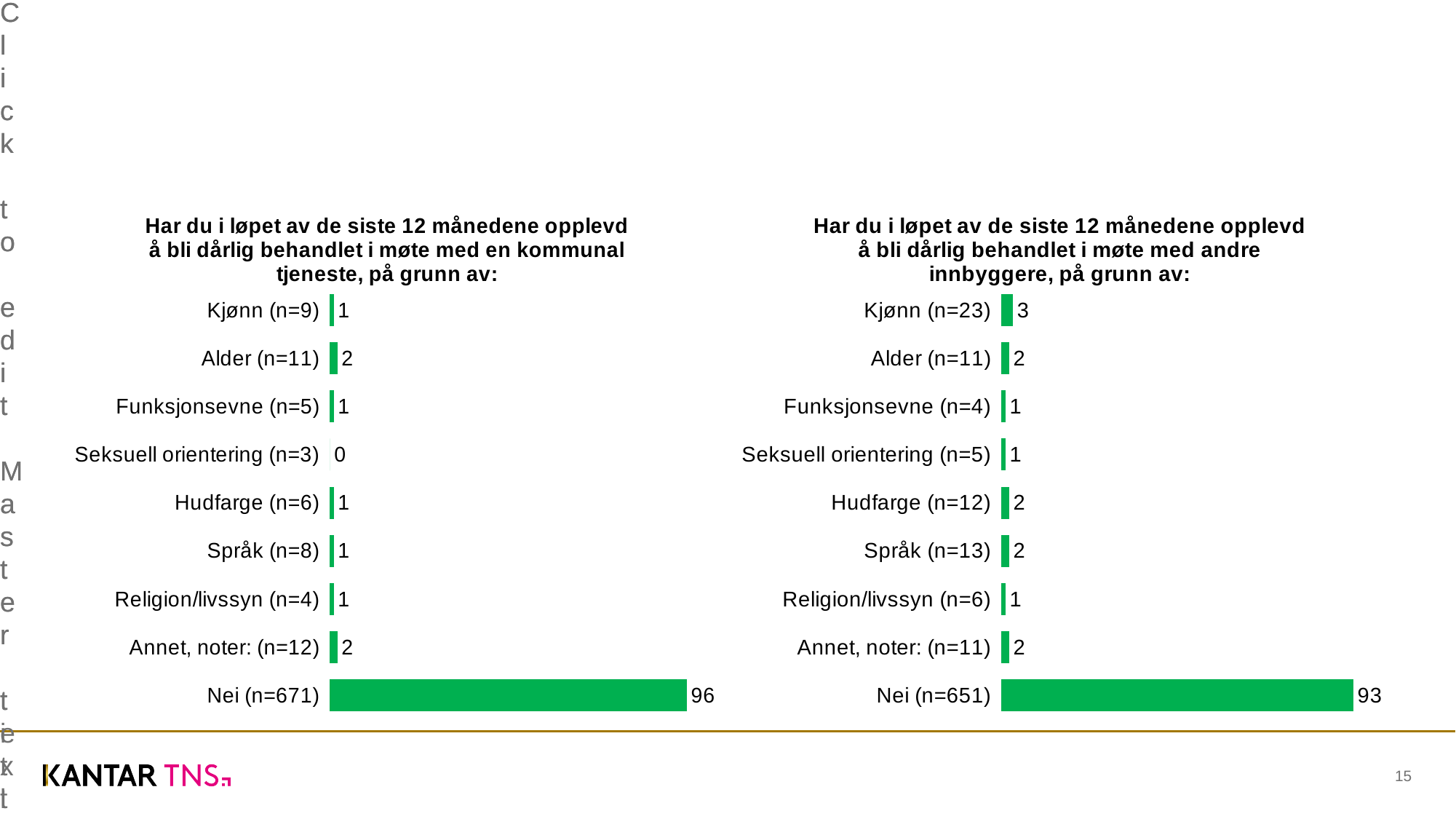
In the right chart (andre innbyggere), what is the difference between Nei (n=651) and Kjønn (n=23)? 90 In the left chart (kommunal tjeneste), which category has the lowest value? Seksuell orientering (n=3) In the right chart (andre innbyggere), what is the value for Kjønn (n=23)? 3 In the left chart (kommunal tjeneste), what is the value for Seksuell orientering (n=3)? 0 In the right chart (andre innbyggere), what is the value for Nei (n=651)? 93 What is the difference between the Nei value in the left chart (96) and the Nei value in the right chart (93)? 3 What type of chart is used on this slide? Bar chart In the left chart (kommunal tjeneste), which category has the highest value? Nei (n=671) In the left chart (kommunal tjeneste), what is the value for Nei (n=671)? 96 How many categories are shown in the left chart (kommunal tjeneste)? 9 What colour are the bars in both charts? Green Which is larger: the value for Kjønn in the left chart or the value for Kjønn in the right chart? Right chart (Kjønn, 3)